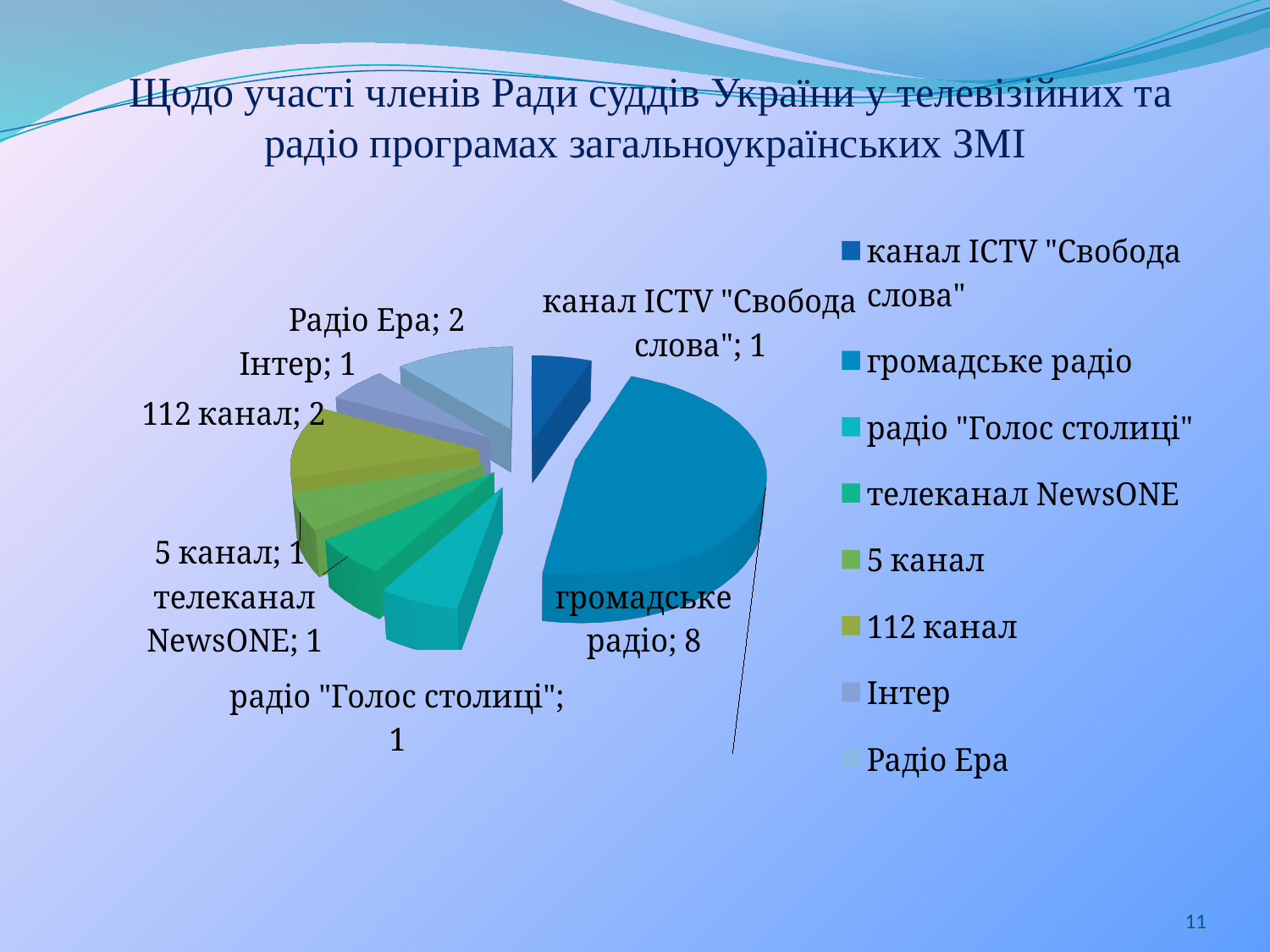
What is the value for канал ICTV "Свобода слова"? 1 What is the value for 112 канал? 2 What is the value for громадське радіо? 8 What is the value for телеканал NewsONE? 1 How many entries does the legend list? 8 What is the sum of all the values shown in the pie chart? 17 Which is larger, the value for 112 канал or the value for Інтер? 112 канал What is the difference between the values for громадське радіо and Радіо Ера? 6 How many categories (slices) does the pie chart have? 8 What kind of chart is shown on the slide? pie chart What is the value for Радіо Ера? 2 Which category has the largest slice of the pie? громадське радіо